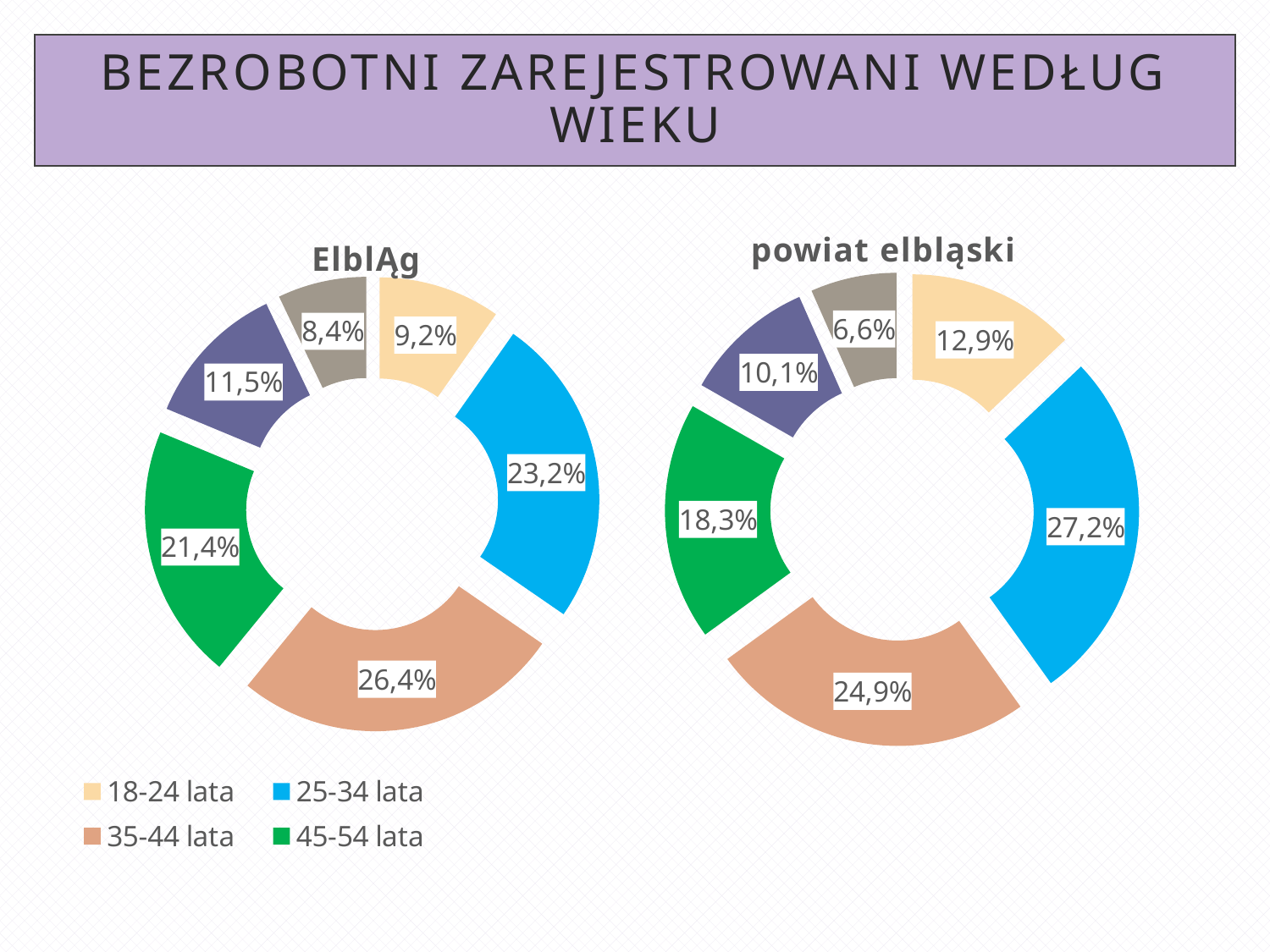
In the Elbląg chart, what percentage is shown for the 25-34 lata group? 23,2% In the powiat elbląski chart, which age group has the largest share? 25-34 lata How many entries does the legend list? 4 What type of chart is used for the Elbląg data? Doughnut (pie) chart In the powiat elbląski chart, what percentage is shown for the 35-44 lata group? 24,9% In the Elbląg chart, what is the difference in percentage points between the 35-44 lata and 25-34 lata groups? 3,2 How many slices does the Elbląg chart have? 6 In the powiat elbląski chart, what percentage is shown for the 45-54 lata group? 18,3% In the Elbląg chart, what percentage is shown for the 18-24 lata group? 9,2% In the powiat elbląski chart, what is the difference in percentage points between the 25-34 lata and 35-44 lata groups? 2,3 Is the share of the 18-24 lata group larger in the Elbląg chart or in the powiat elbląski chart? powiat elbląski In the Elbląg chart, which age group has the largest share? 35-44 lata